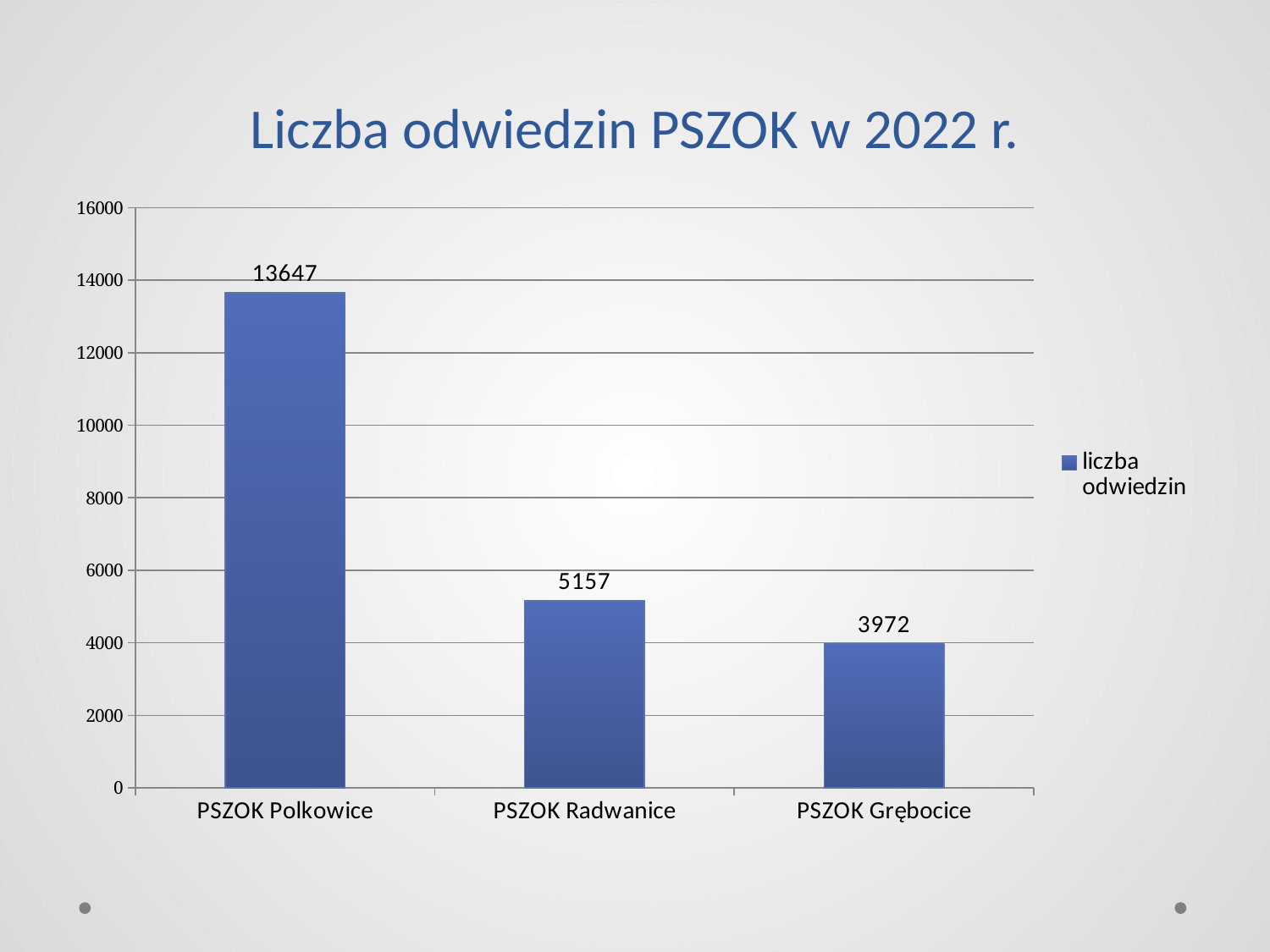
What is the number of visits for PSZOK Polkowice? 13647 Which PSZOK had the highest number of visits? PSZOK Polkowice How many PSZOK locations are shown on the chart? 3 What is the difference in visits between PSZOK Radwanice and PSZOK Grębocice? 1185 What type of chart is shown on the slide? bar chart What is the difference in visits between PSZOK Polkowice and PSZOK Radwanice? 8490 Which PSZOK had the lowest number of visits? PSZOK Grębocice What is the number of visits for PSZOK Radwanice? 5157 Which had more visits, PSZOK Radwanice or PSZOK Grębocice? PSZOK Radwanice What is the number of visits for PSZOK Grębocice? 3972 Is the value for PSZOK Polkowice greater or less than 12000? greater What is the title of the chart? Liczba odwiedzin PSZOK w 2022 r.